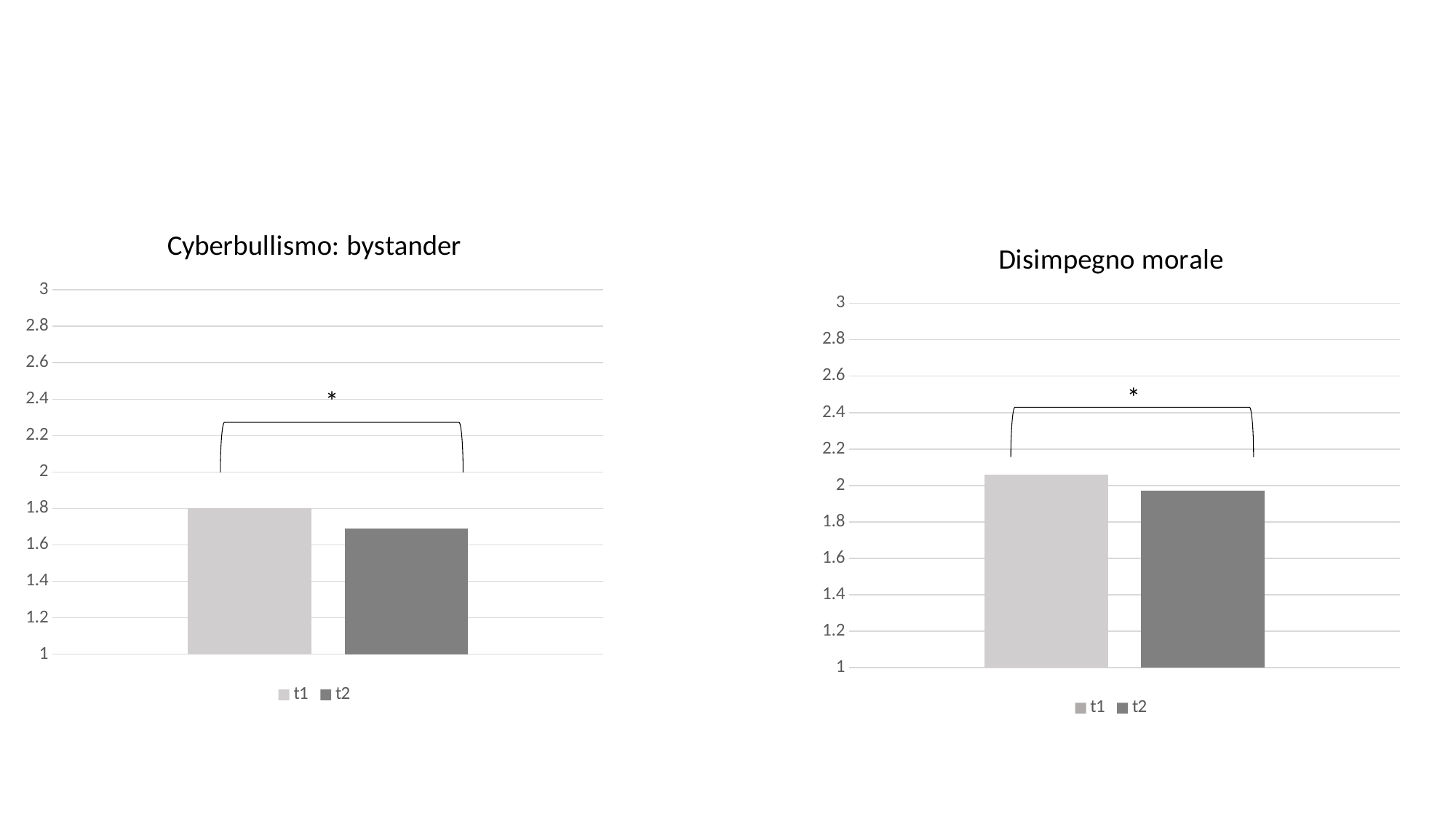
What kind of chart is the 'Disimpegno morale' chart? bar chart What is the title of the chart on the left of the slide? Cyberbullismo: bystander In the 'Cyberbullismo: bystander' chart, is the value for t2 greater or less than 1.8? less In the 'Disimpegno morale' chart, which series is higher, t1 or t2? t1 In the 'Cyberbullismo: bystander' chart, which series is lower, t1 or t2? t2 In the 'Disimpegno morale' chart, is the value for t1 greater or less than 2? greater In the 'Disimpegno morale' chart, how many bars are plotted? 2 In the 'Disimpegno morale' chart, what are the two legend entries? t1 and t2 In the 'Cyberbullismo: bystander' chart, is the value for t1 greater or less than 2? less In the 'Cyberbullismo: bystander' chart, how many series does the legend list? 2 What kind of chart is the 'Cyberbullismo: bystander' chart? bar chart